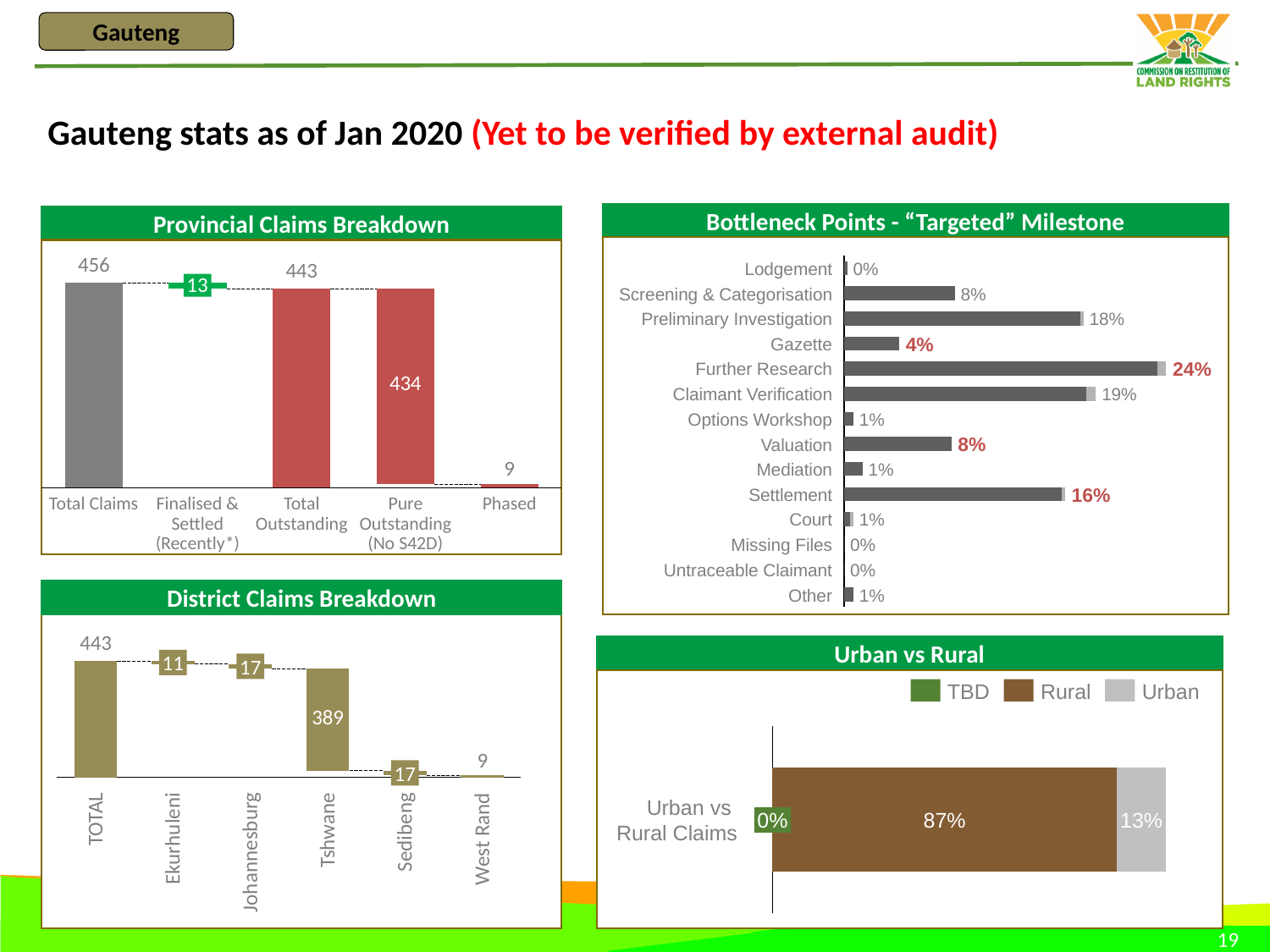
In the District Claims Breakdown chart, how many districts are shown excluding TOTAL? 5 In the Bottleneck Points chart, which category has the highest percentage? Further Research In the Provincial Claims Breakdown chart, what is the difference between Total Claims and Total Outstanding? 13 In the Urban vs Rural chart, how many series does the legend list? 3 In the Bottleneck Points chart, how many categories are listed? 14 In the Provincial Claims Breakdown chart, what is the value for Pure Outstanding (No S42D)? 434 In the Bottleneck Points chart, what is the value for Settlement? 16% In the Bottleneck Points chart, which is larger, Preliminary Investigation or Claimant Verification? Claimant Verification In the Urban vs Rural chart, what share of claims is Rural? 87% In the District Claims Breakdown chart, which district has the lowest value? West Rand In the Provincial Claims Breakdown chart, what is the value for Total Claims? 456 In the District Claims Breakdown chart, what is the value for Tshwane? 389